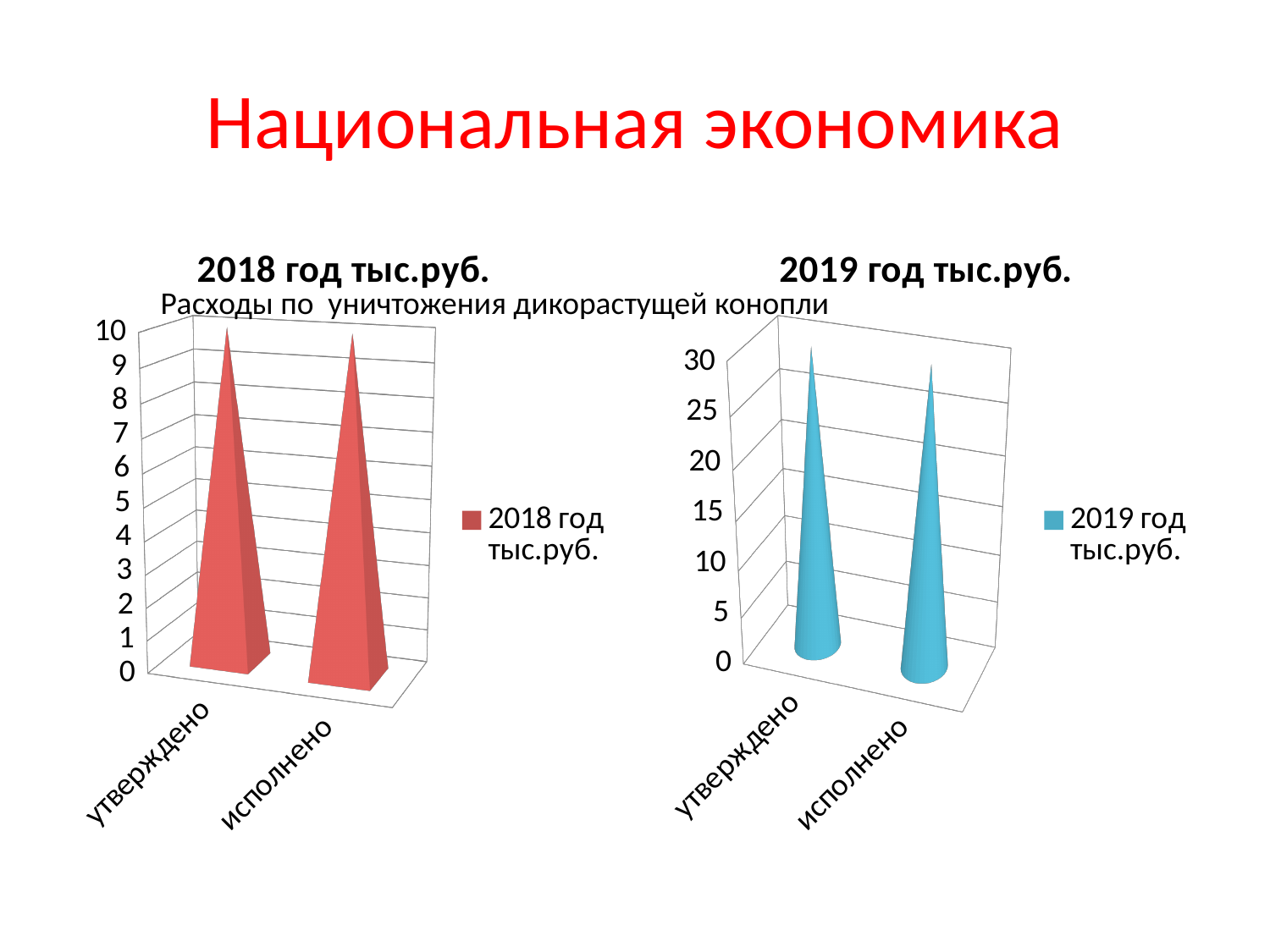
On the chart titled "2018 год тыс.руб.", is the value for исполнено greater or less than 5? greater What is the legend entry on the chart titled "2019 год тыс.руб."? 2019 год тыс.руб. On the chart titled "2019 год тыс.руб.", how many series does the legend list? 1 On the chart titled "2019 год тыс.руб.", is the value for исполнено greater or less than 15? greater What kind of chart is the chart titled "2018 год тыс.руб."? bar chart What colour are the bars on the chart titled "2018 год тыс.руб."? red On the chart titled "2018 год тыс.руб.", how many series does the legend list? 1 On the chart titled "2018 год тыс.руб.", how many categories are shown on the x axis? 2 On the chart titled "2018 год тыс.руб.", is the value for утверждено greater or less than 5? greater On the chart titled "2019 год тыс.руб.", how many categories are shown on the x axis? 2